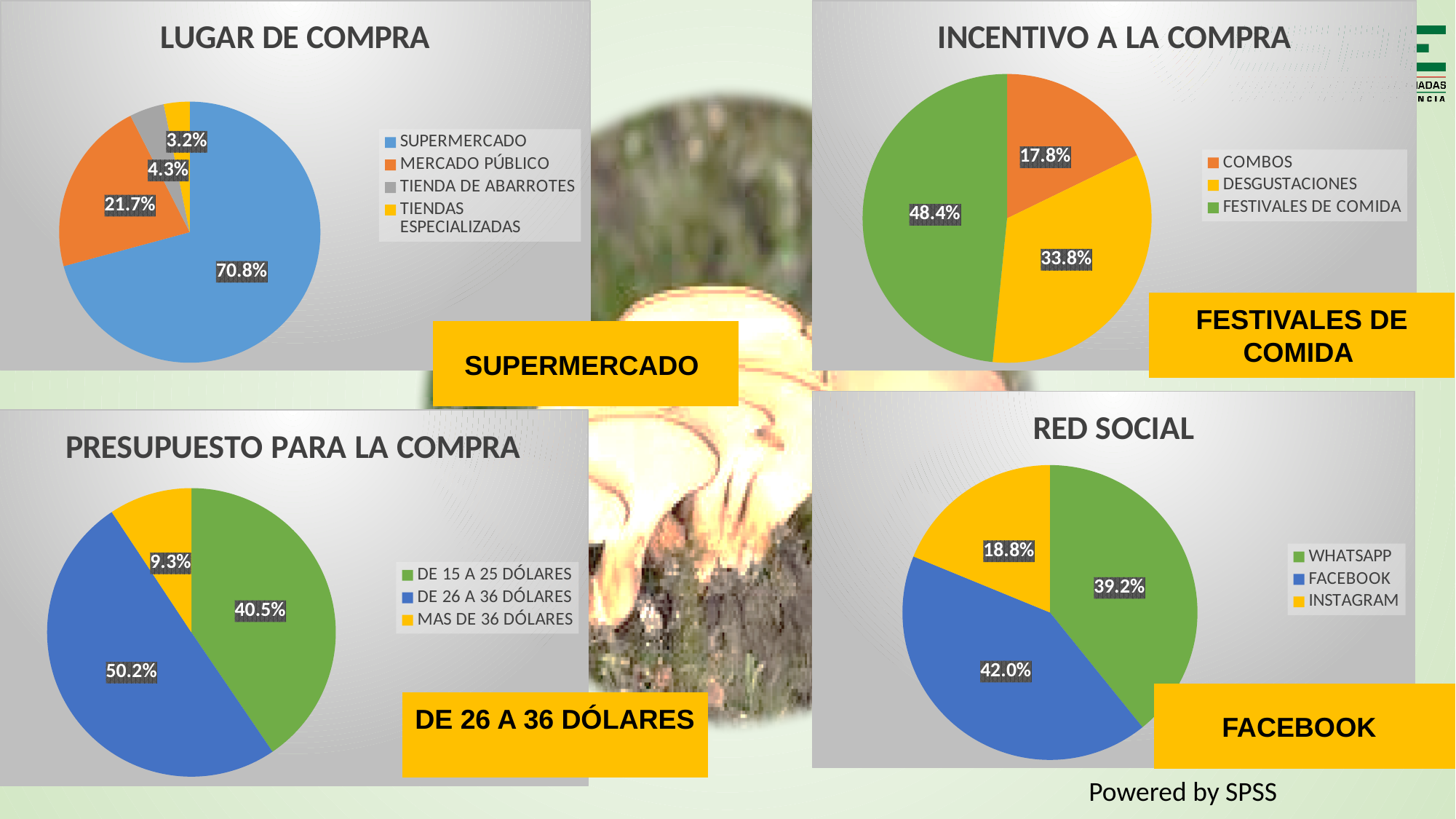
In the 'INCENTIVO A LA COMPRA' chart, which category has the largest slice? FESTIVALES DE COMIDA In the 'LUGAR DE COMPRA' chart, what is the difference between MERCADO PÚBLICO and TIENDA DE ABARROTES? 17.4% In the 'LUGAR DE COMPRA' chart, how many categories does the legend list? 4 In the 'PRESUPUESTO PARA LA COMPRA' chart, what share does MAS DE 36 DÓLARES have? 9.3% In the 'RED SOCIAL' chart, what share does FACEBOOK have? 42.0% What kind of chart is the 'RED SOCIAL' chart? Pie chart In the 'INCENTIVO A LA COMPRA' chart, what share does DESGUSTACIONES have? 33.8% In the 'RED SOCIAL' chart, what is the difference between WHATSAPP and INSTAGRAM? 20.4% In the 'LUGAR DE COMPRA' chart, which category has the smallest slice? TIENDAS ESPECIALIZADAS In the 'INCENTIVO A LA COMPRA' chart, how many categories are shown? 3 In the 'PRESUPUESTO PARA LA COMPRA' chart, which is larger, DE 15 A 25 DÓLARES or DE 26 A 36 DÓLARES? DE 26 A 36 DÓLARES